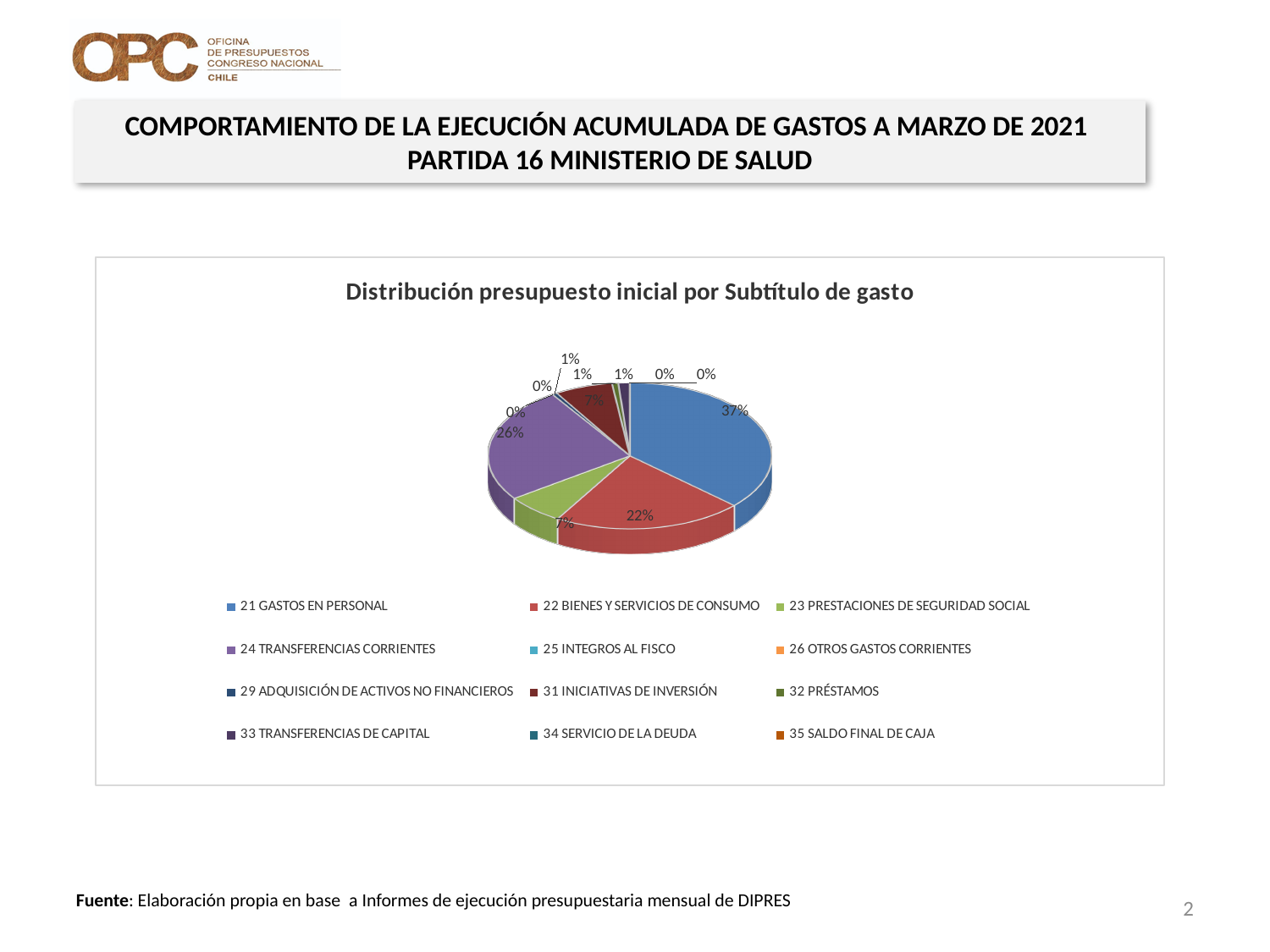
What share of the pie does 24 TRANSFERENCIAS CORRIENTES represent? 26% What is the difference in percentage points between the shares of 21 GASTOS EN PERSONAL and 24 TRANSFERENCIAS CORRIENTES? 11 percentage points What share of the pie does 23 PRESTACIONES DE SEGURIDAD SOCIAL represent? 7% What share of the pie does 21 GASTOS EN PERSONAL represent? 37% Which category has the largest share of the pie? 21 GASTOS EN PERSONAL Which has a larger share: 22 BIENES Y SERVICIOS DE CONSUMO or 24 TRANSFERENCIAS CORRIENTES? 24 TRANSFERENCIAS CORRIENTES What kind of chart is shown on the slide? Pie chart How many categories does the legend list? 12 What is the difference in percentage points between the shares of 21 GASTOS EN PERSONAL and 22 BIENES Y SERVICIOS DE CONSUMO? 15 percentage points What is the title of the chart? Distribución presupuesto inicial por Subtítulo de gasto